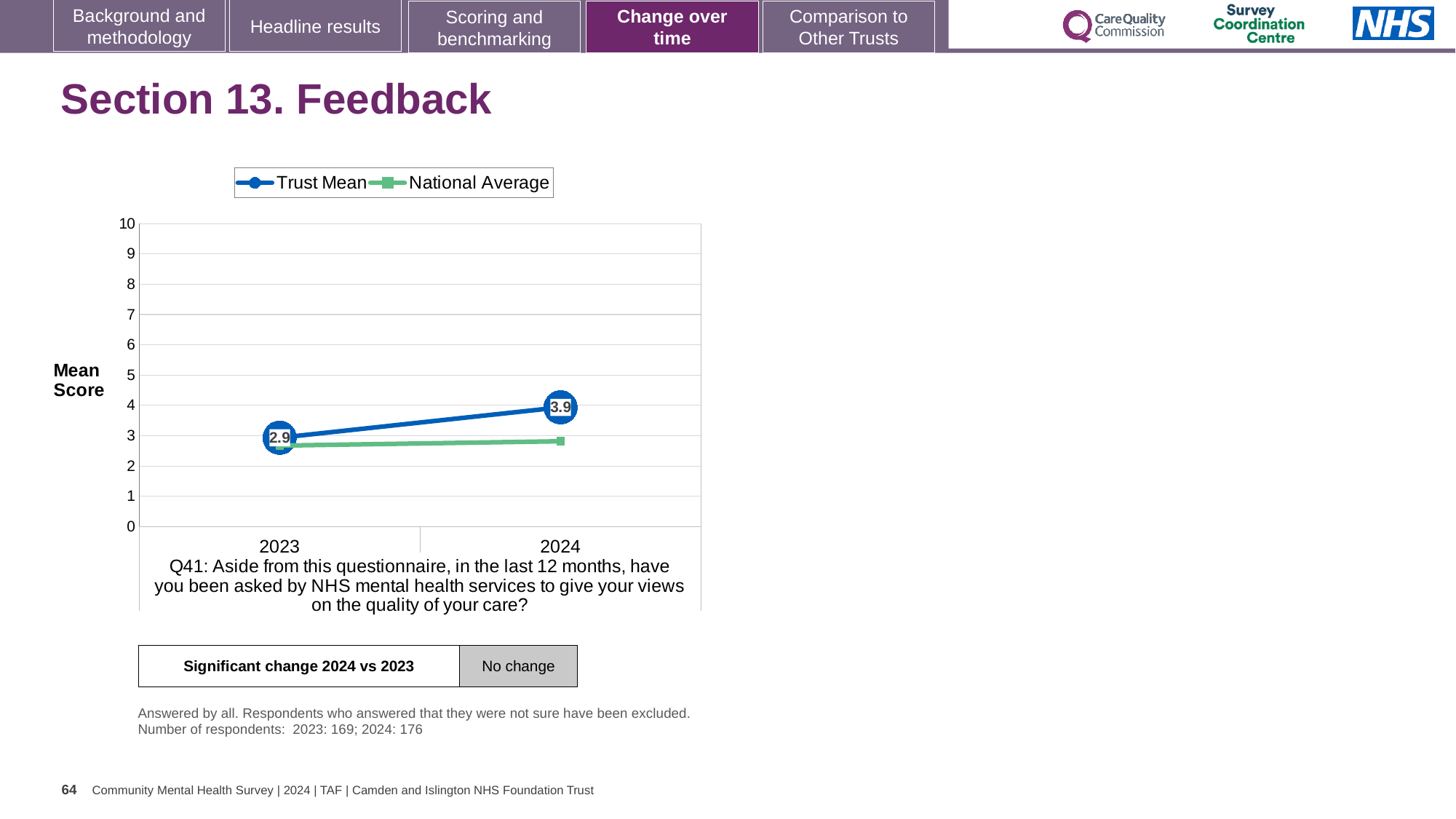
Which year has the higher Trust Mean score, 2023 or 2024? 2024 Is the National Average value for 2023 greater or less than 4? less What kind of chart is shown on the slide? line chart Is the National Average value for 2024 greater or less than 3? less By how much did the Trust Mean score change from 2023 to 2024? 1.0 Does the Trust Mean line rise or fall from 2023 to 2024? rise What is the label on the y axis of the chart? Mean Score What is the Trust Mean score for 2023? 2.9 How many years are shown on the x axis of the chart? 2 In 2024, which is higher, the Trust Mean or the National Average? Trust Mean What is the Trust Mean score for 2024? 3.9 How many series does the chart legend list? 2